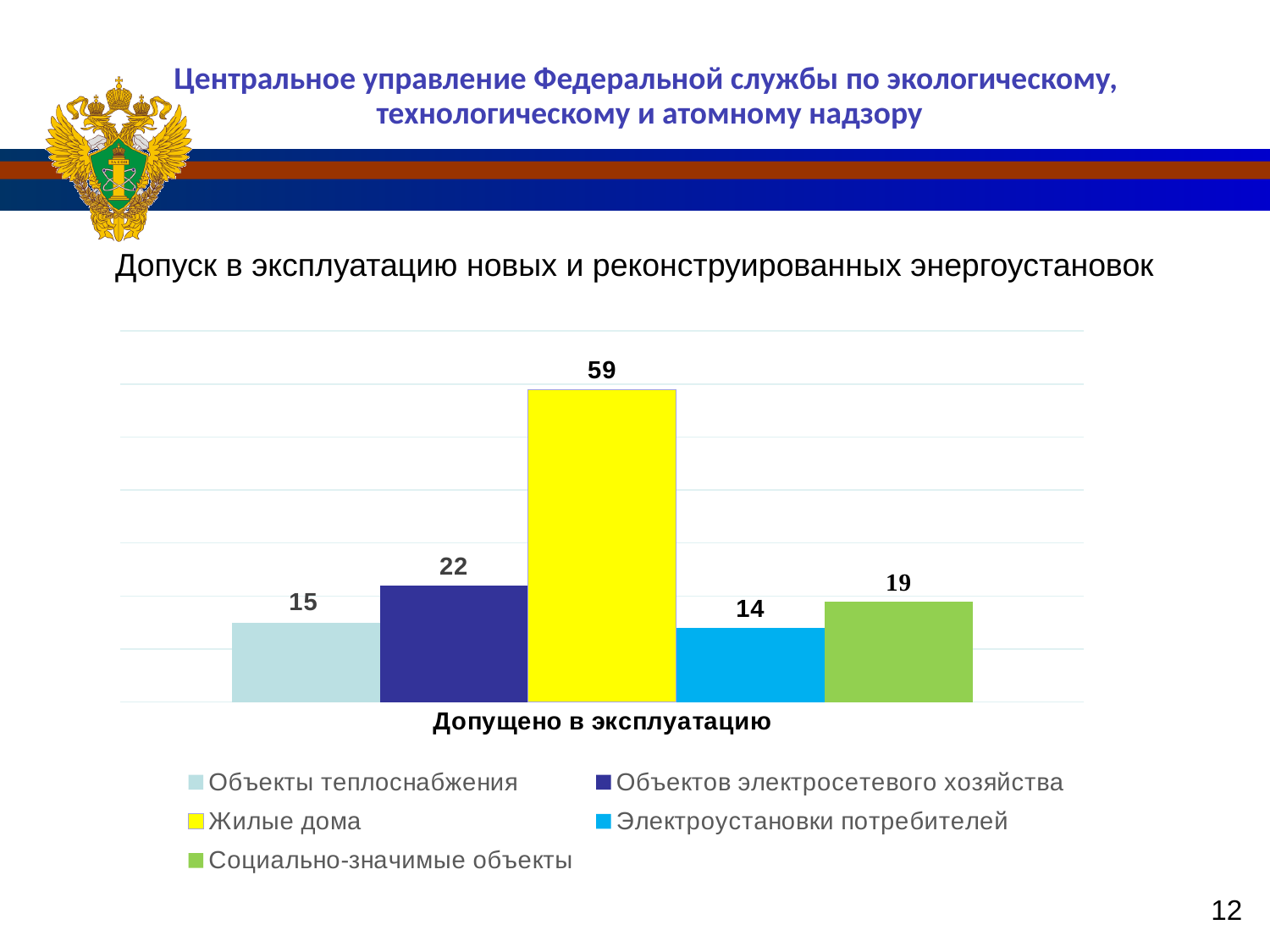
How many series does the legend list? 5 What colour is the bar for Жилые дома? Yellow What kind of chart is shown on the slide? Bar chart Which series has the highest value? Жилые дома What is the value for Объекты теплоснабжения? 15 Which is larger, the value for Социально-значимые объекты or the value for Объекты теплоснабжения? Социально-значимые объекты What is the value for Социально-значимые объекты? 19 What is the category label shown under the bars? Допущено в эксплуатацию Which series has the lowest value? Электроустановки потребителей What is the difference between the values for Жилые дома and Объектов электросетевого хозяйства? 37 What is the value for Жилые дома? 59 What is the value for Электроустановки потребителей? 14